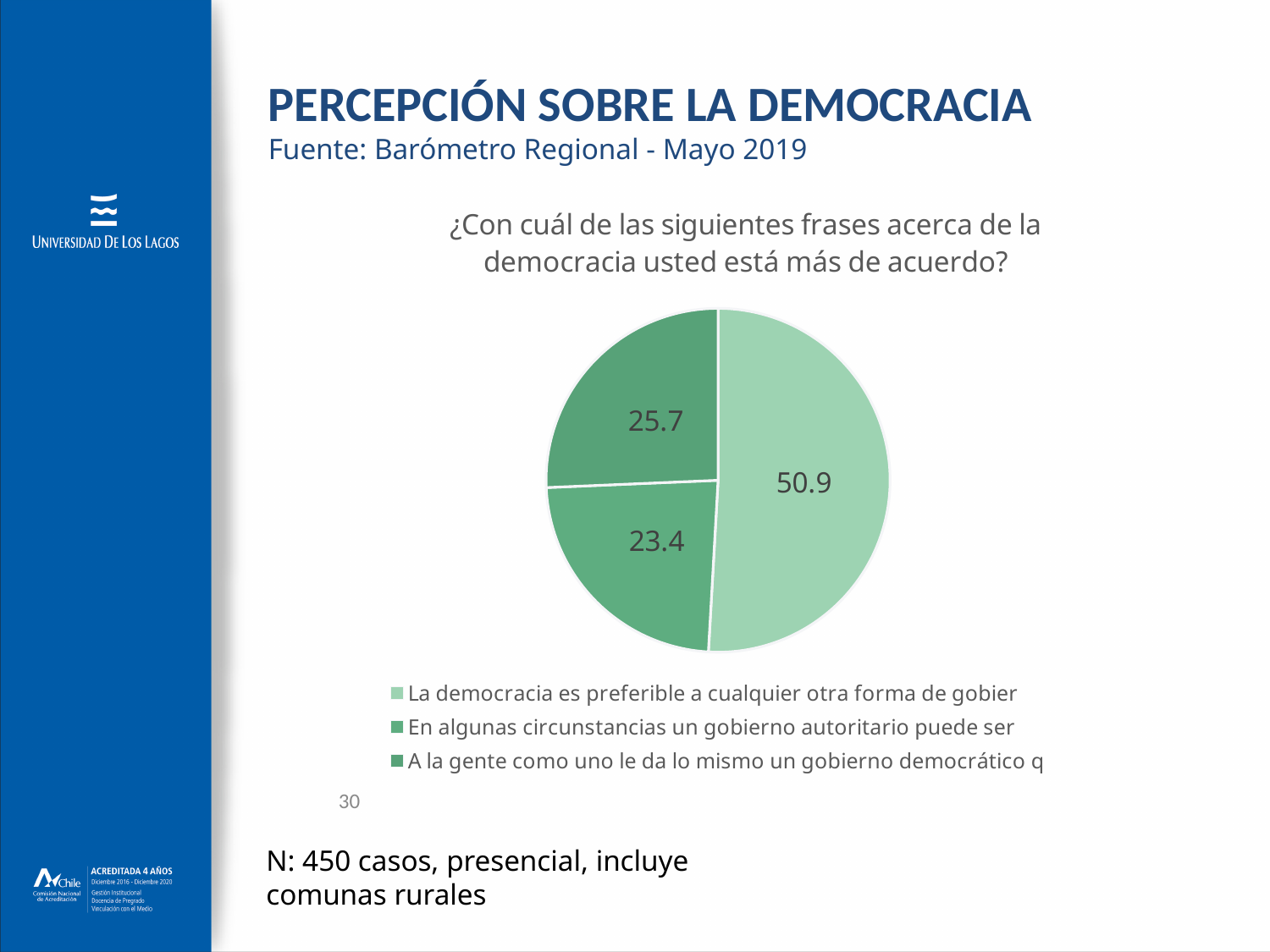
What is the difference between the largest slice (50.9) and the slice labelled 25.7? 25.2 What is the value of the slice for "En algunas circunstancias un gobierno autoritario puede ser..."? 23.4 What question is shown as the title of the pie chart? ¿Con cuál de las siguientes frases acerca de la democracia usted está más de acuerdo? What kind of chart is shown on the slide? pie chart How many slices does the pie chart have? 3 How many entries does the chart legend list? 3 What is the difference between the slices labelled 25.7 and 23.4? 2.3 What is the value of the slice for "A la gente como uno le da lo mismo un gobierno democrático q..."? 25.7 Which is larger: the slice for "En algunas circunstancias un gobierno autoritario puede ser..." or the slice for "A la gente como uno le da lo mismo un gobierno democrático q..."? A la gente como uno le da lo mismo un gobierno democrático q... What is the value of the slice for "La democracia es preferible a cualquier otra forma de gobier..."? 50.9 Which response has the largest slice of the pie? La democracia es preferible a cualquier otra forma de gobier... Which response has the smallest slice of the pie? En algunas circunstancias un gobierno autoritario puede ser...